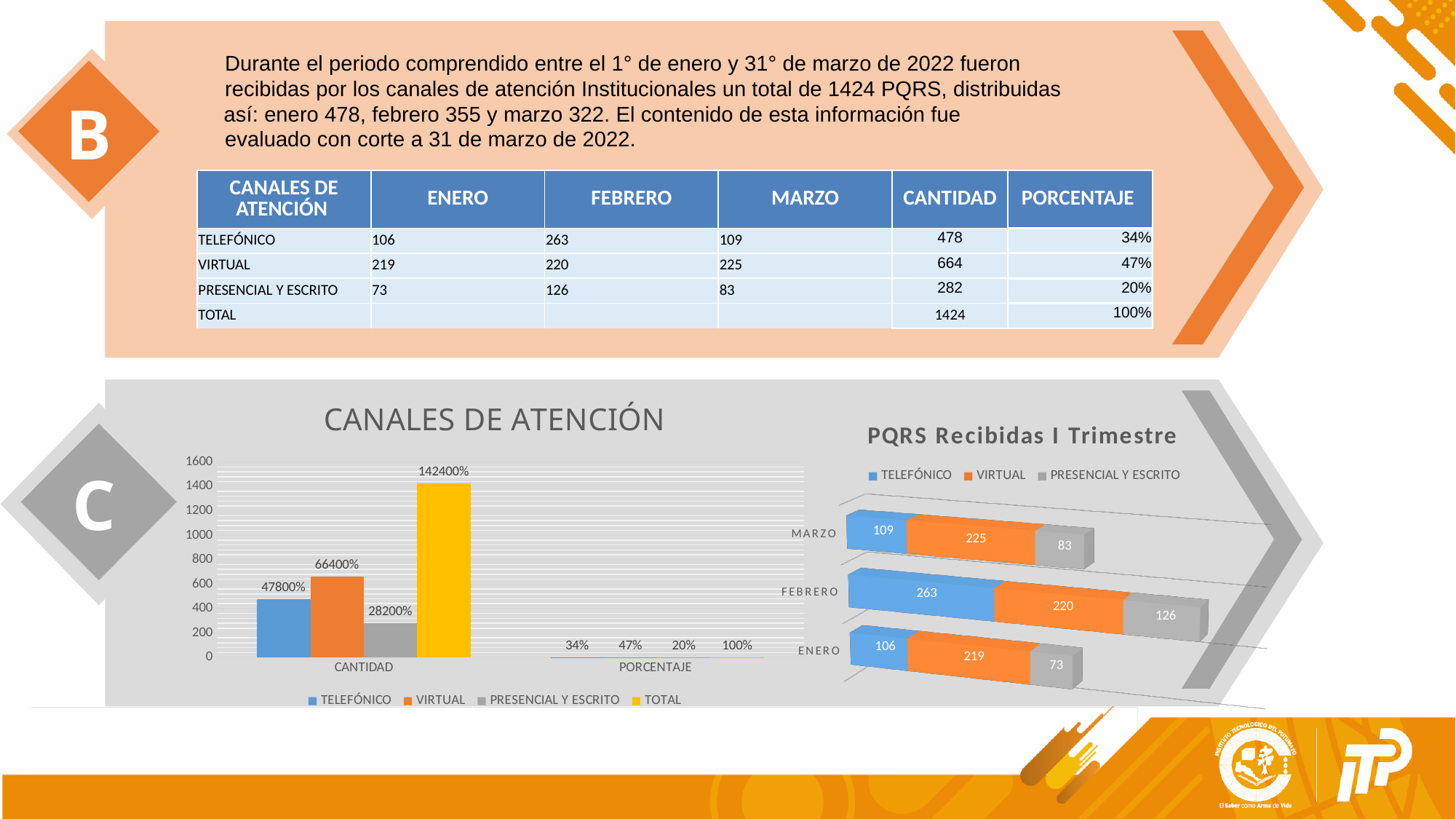
In the 'CANALES DE ATENCIÓN' chart, is the VIRTUAL bar under CANTIDAD greater or less than 600? greater In the 'PQRS Recibidas I Trimestre' chart, what is the total of the stacked bar for FEBRERO? 609 In the 'PQRS Recibidas I Trimestre' chart, what is the value for PRESENCIAL Y ESCRITO in MARZO? 83 What kind of chart is 'CANALES DE ATENCIÓN'? bar chart In the 'CANALES DE ATENCIÓN' chart, what data label is shown for VIRTUAL under PORCENTAJE? 47% In the 'PQRS Recibidas I Trimestre' chart, what is the value for TELEFÓNICO in ENERO? 106 In the 'CANALES DE ATENCIÓN' chart, what data label is shown on the TOTAL bar under CANTIDAD? 142400% In the 'PQRS Recibidas I Trimestre' chart, which month has the lowest PRESENCIAL Y ESCRITO value? ENERO In the 'PQRS Recibidas I Trimestre' chart, what is the difference between the TELEFÓNICO values for FEBRERO and MARZO? 154 In the 'PQRS Recibidas I Trimestre' chart, how many series does the legend list? 3 In the 'PQRS Recibidas I Trimestre' chart, which month has the highest TELEFÓNICO value? FEBRERO In the 'PQRS Recibidas I Trimestre' chart, what is the value for VIRTUAL in FEBRERO? 220